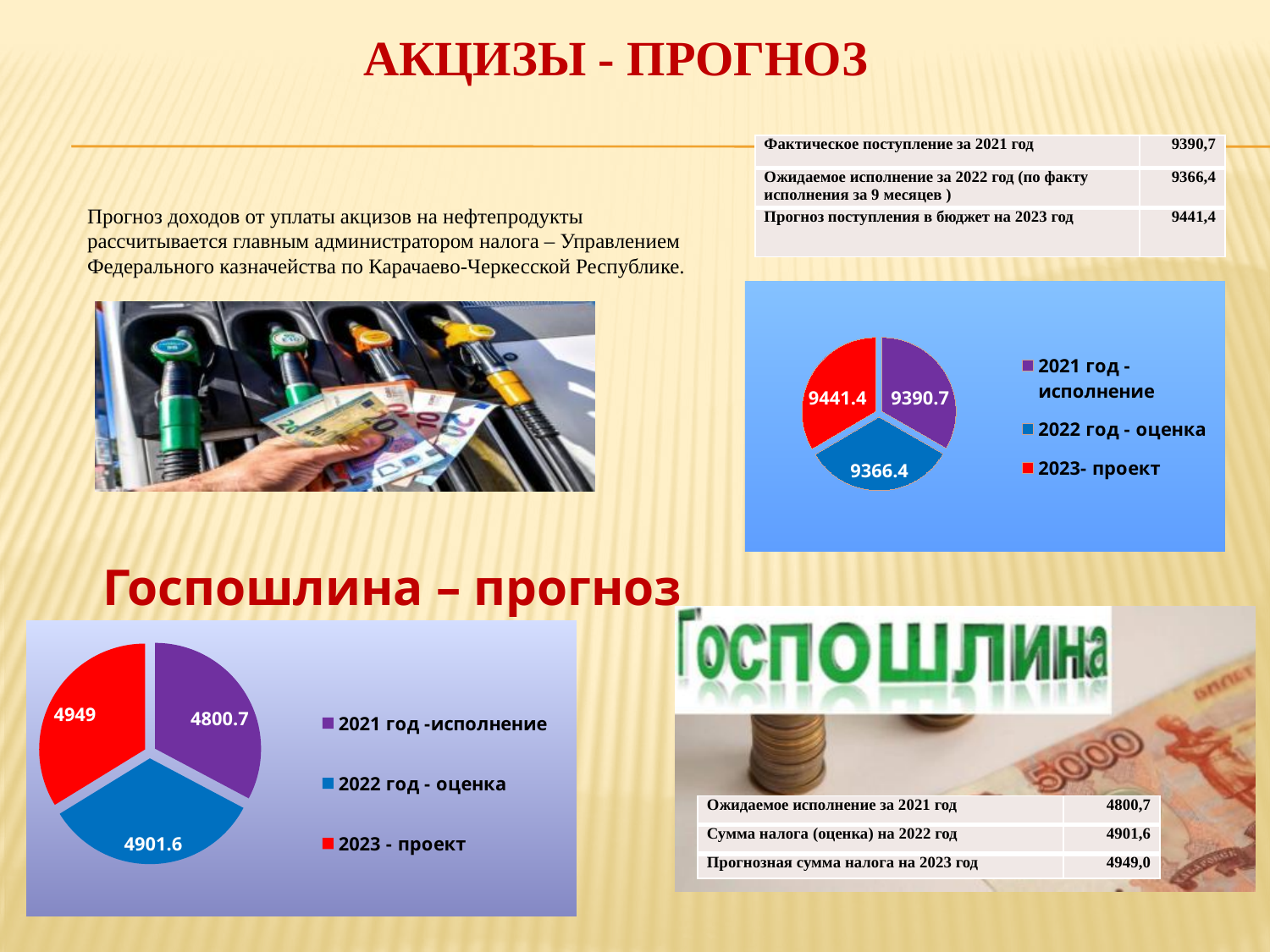
In the pie chart in the upper right of the slide, which category has the smallest value? 2022 год - оценка In the pie chart in the lower left of the slide, what is the value for "2023 - проект"? 4949 In the pie chart in the lower left of the slide, which is larger: the value for "2021 год -исполнение" or the value for "2022 год - оценка"? 2022 год - оценка In the pie chart in the upper right of the slide, what is the value for "2023- проект"? 9441.4 In the pie chart in the upper right of the slide, what is the value for "2021 год - исполнение"? 9390.7 In the pie chart in the lower left of the slide, what is the difference between the values for "2023 - проект" and "2021 год -исполнение"? 148.3 In the pie chart in the upper right of the slide, how many slices does the pie have? 3 What type of chart is shown in the upper right of the slide? Pie chart In the pie chart in the lower left of the slide, what is the value for "2022 год - оценка"? 4901.6 In the pie chart in the lower left of the slide, which category has the largest value? 2023 - проект In the pie chart in the upper right of the slide, what is the difference between the values for "2023- проект" and "2021 год - исполнение"? 50.7 In the pie chart in the lower left of the slide, what colour is the slice for "2023 - проект"? Red